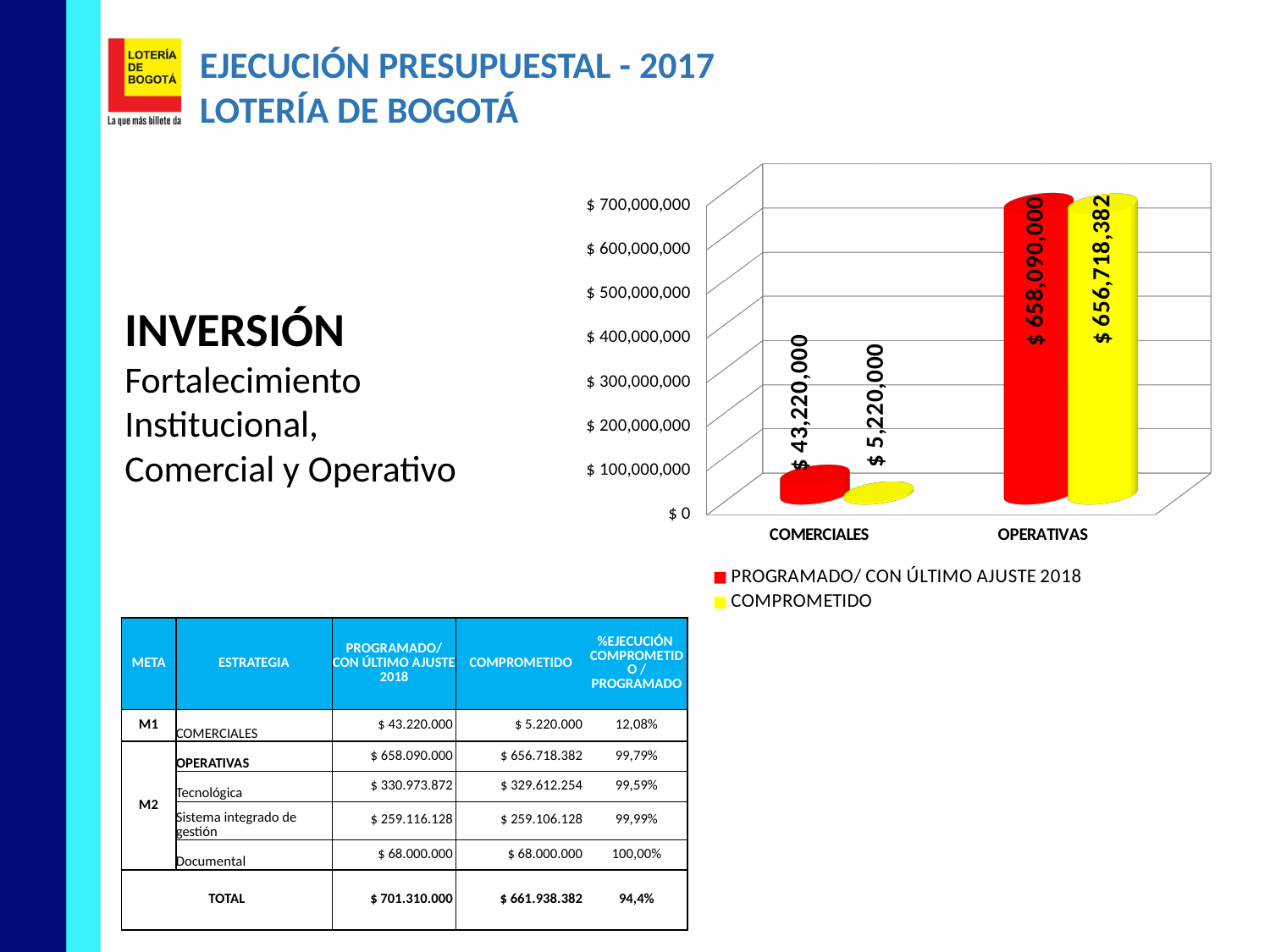
What is the PROGRAMADO/ CON ÚLTIMO AJUSTE 2018 value for COMERCIALES in the chart? $ 43,220,000 Is the PROGRAMADO/ CON ÚLTIMO AJUSTE 2018 value for OPERATIVAS greater or less than $ 600,000,000? greater What is the COMPROMETIDO value for COMERCIALES in the chart? $ 5,220,000 How many categories are shown on the x axis of the chart? 2 How many series does the chart legend list? 2 Which category has the lowest COMPROMETIDO value in the chart? COMERCIALES What is the PROGRAMADO/ CON ÚLTIMO AJUSTE 2018 value for OPERATIVAS in the chart? $ 658,090,000 What is the difference between the PROGRAMADO/ CON ÚLTIMO AJUSTE 2018 and COMPROMETIDO values for COMERCIALES in the chart? $ 38,000,000 Which is larger for COMERCIALES in the chart: PROGRAMADO/ CON ÚLTIMO AJUSTE 2018 or COMPROMETIDO? PROGRAMADO/ CON ÚLTIMO AJUSTE 2018 What kind of chart is shown on the slide? bar chart Which category has the highest PROGRAMADO/ CON ÚLTIMO AJUSTE 2018 value in the chart? OPERATIVAS What is the COMPROMETIDO value for OPERATIVAS in the chart? $ 656,718,382